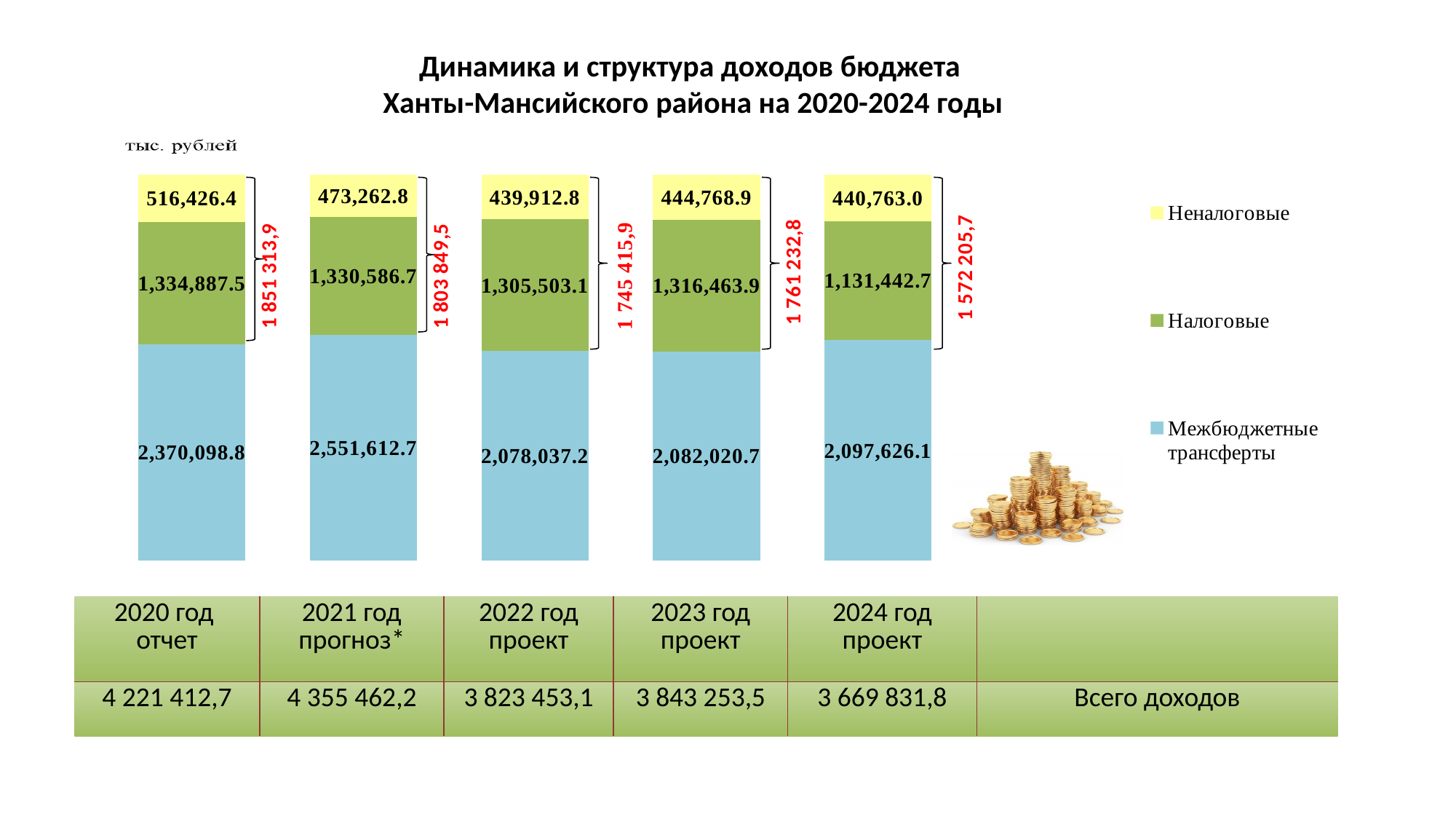
How many years (bars) are shown in the chart? 5 In which year is Налоговые the lowest? 2024 год проект What is the difference in Межбюджетные трансферты between 2021 год прогноз* and 2020 год отчет? 181,513.9 How many series does the legend list? 3 In which year is Межбюджетные трансферты the highest? 2021 год прогноз* What is the value of Налоговые for 2024 год проект? 1,131,442.7 Does the Неналоговые value rise or fall from 2020 год отчет to 2022 год проект? Fall What is the value of Неналоговые for 2020 год отчет? 516,426.4 What kind of chart is shown on the slide? Stacked bar chart What is the value of Межбюджетные трансферты for 2021 год прогноз*? 2,551,612.7 Which year has the larger Налоговые value, 2022 год проект or 2023 год проект? 2023 год проект What is the total income (Всего доходов) for 2020 год отчет? 4 221 412,7